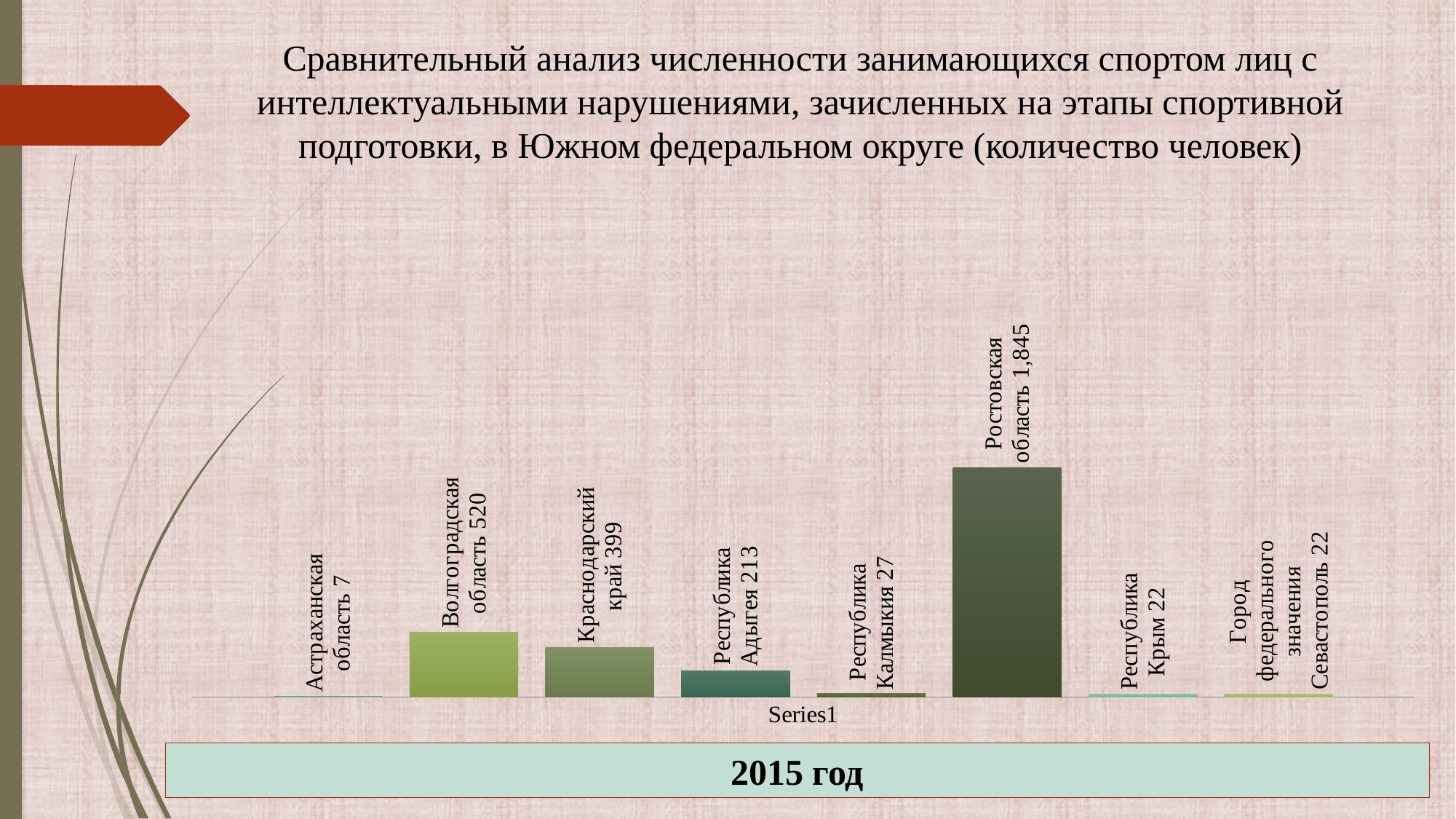
Which is larger, the value for Краснодарский край or the value for Республика Адыгея? Краснодарский край What is the value for Республика Калмыкия? 27 What is the value for Республика Адыгея? 213 What is the value for Ростовская область? 1,845 What is the difference between the values for Волгоградская область and Краснодарский край? 121 What is the value for Волгоградская область? 520 How many regions are shown in the chart? 8 What year is indicated in the box below the chart? 2015 год Which region has the lowest value? Астраханская область What kind of chart is shown on the slide? Bar chart Which region has the highest value? Ростовская область What is the difference between the values for Ростовская область and Волгоградская область? 1,325